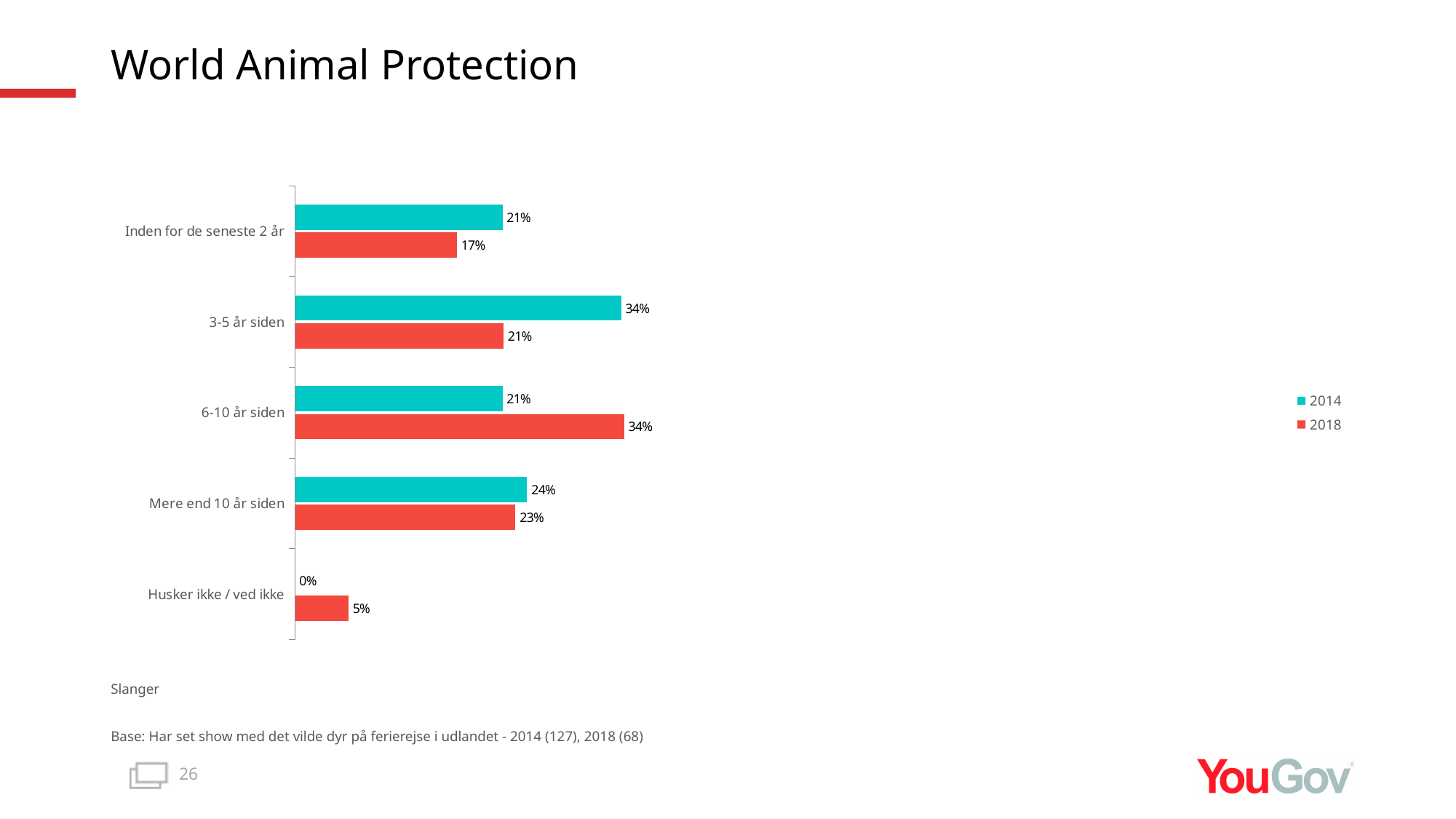
What kind of chart is shown on the slide? Bar chart Which colour represents the 2018 series in the legend? Red Which category has the lowest 2014 value? Husker ikke / ved ikke What is the difference between the 2014 and 2018 values for "3-5 år siden"? 13 percentage points How many categories are shown on the chart? 5 What is the 2014 value for "3-5 år siden"? 34% What is the 2014 value for "Mere end 10 år siden"? 24% Which category has the highest 2018 value? 6-10 år siden How many series does the legend list? 2 What is the 2018 value for "Inden for de seneste 2 år"? 17% For "6-10 år siden", which year has the larger value, 2014 or 2018? 2018 What is the 2018 value for "Husker ikke / ved ikke"? 5%